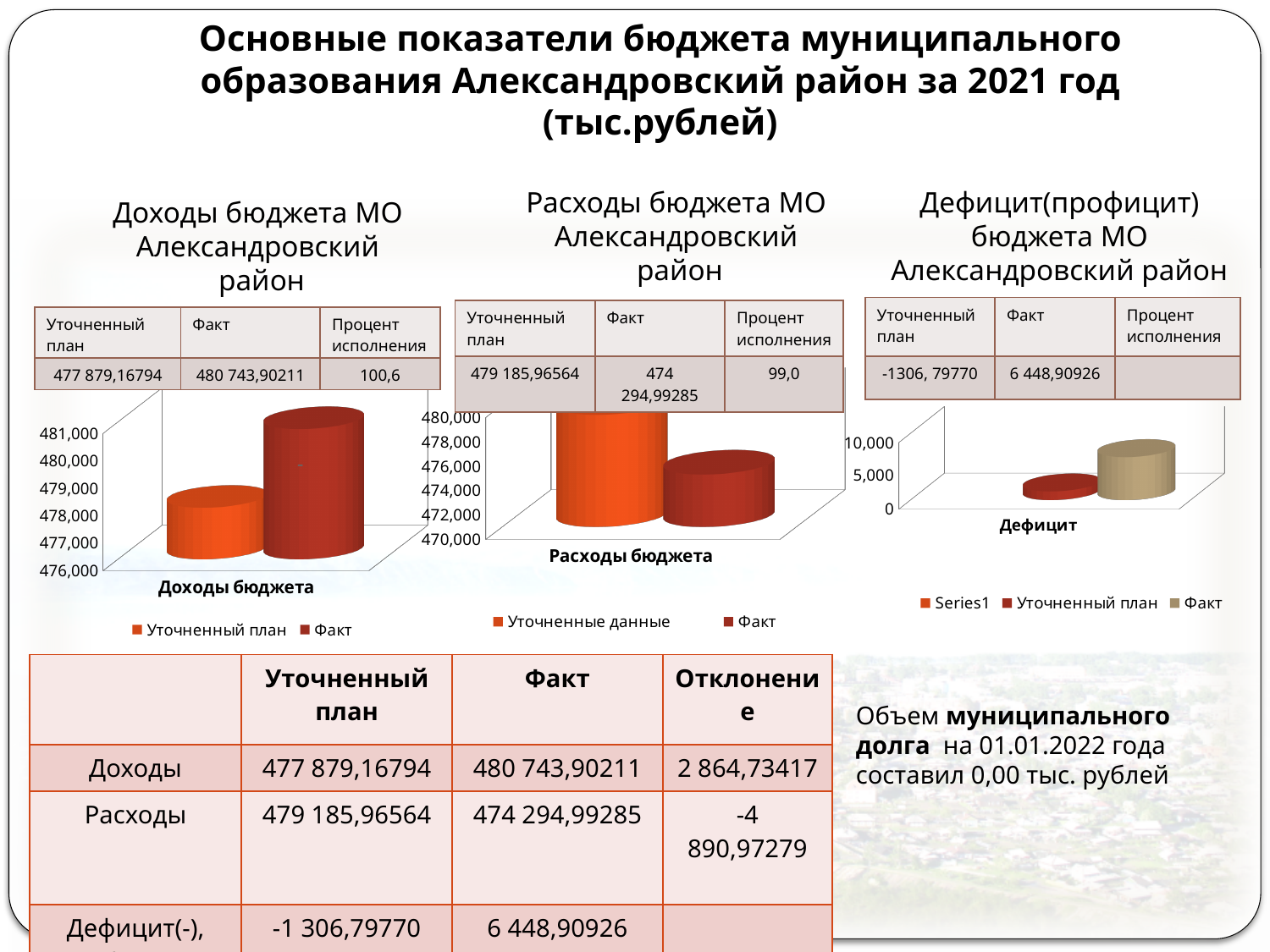
In the 'Расходы бюджета МО Александровский район' chart, what is the Процент исполнения value shown in the table above the chart? 99,0 In the 'Доходы бюджета МО Александровский район' chart, how many series does the legend list? 2 In the 'Расходы бюджета МО Александровский район' chart, is the value for Факт greater or less than 476,000? less In the 'Дефицит(профицит) бюджета МО Александровский район' chart, how many entries does the legend list? 3 In the 'Доходы бюджета МО Александровский район' chart, what is the Факт value shown in the table above the chart? 480 743,90211 In the 'Доходы бюджета МО Александровский район' chart, is the value for Факт greater or less than 480,000? greater What is the category label on the x axis of the 'Доходы бюджета МО Александровский район' chart? Доходы бюджета In the 'Доходы бюджета МО Александровский район' chart, what is the difference between Факт and Уточненный план, as printed in the Отклонение column of the bottom table? 2 864,73417 In the 'Доходы бюджета МО Александровский район' chart, which bar is taller: Уточненный план or Факт? Факт In the 'Дефицит(профицит) бюджета МО Александровский район' chart, is the value for Факт greater or less than 5,000? greater What kind of chart is the 'Доходы бюджета МО Александровский район' chart? bar chart In the 'Расходы бюджета МО Александровский район' chart, which bar is taller: Уточненные данные or Факт? Уточненные данные